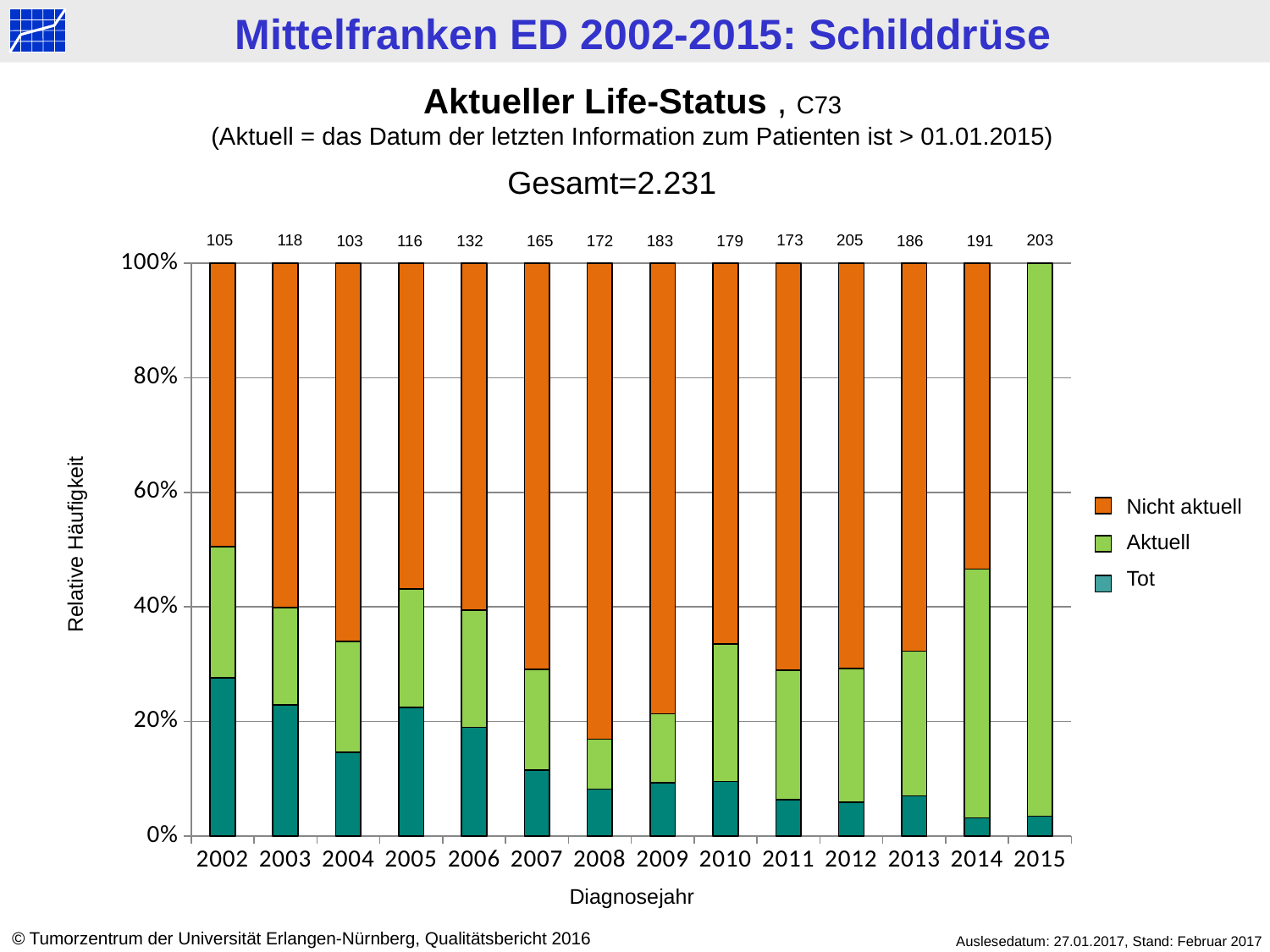
Does the share of 'Tot' generally rise or fall from 2002 to 2015? fall How many series does the legend list? 3 Is the share of 'Tot' in 2002 greater or less than 20%? greater What number is printed above the bar for 2002? 105 Which year has the larger number printed above its bar, 2009 or 2010? 2009 Which year has the lowest number printed above its bar? 2004 Which year has the highest number printed above its bar? 2012 How many diagnosis years (Diagnosejahr) are shown on the x axis? 14 What is the difference between the numbers printed above the bars for 2015 and 2002? 98 What number is printed above the bar for 2015? 203 What number is printed above the bar for 2008? 172 What kind of chart is shown on the slide? stacked bar chart